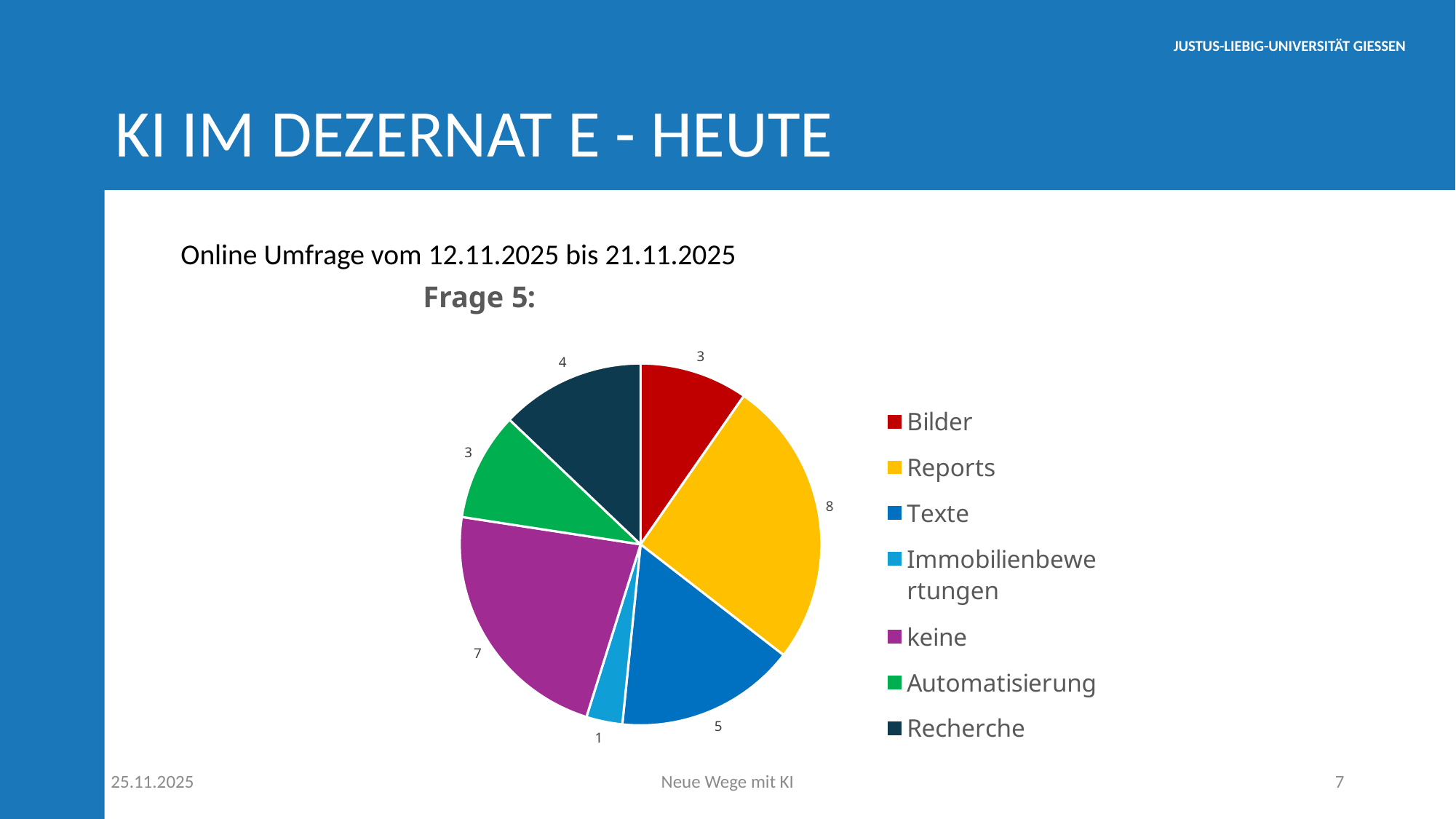
Which category has the smallest slice in the pie chart? Immobilienbewertungen What is the difference between the values for Reports and Texte? 3 What is the value for Reports in the pie chart? 8 What kind of chart is shown on the slide? pie chart Which is larger, the value for Texte or the value for Bilder? Texte How many categories does the pie chart have? 7 What is the title of the chart? Frage 5: What is the value for Immobilienbewertungen in the pie chart? 1 What is the value for Recherche in the pie chart? 4 What is the difference between the values for keine and Recherche? 3 Which category has the largest slice in the pie chart? Reports What is the value for keine in the pie chart? 7